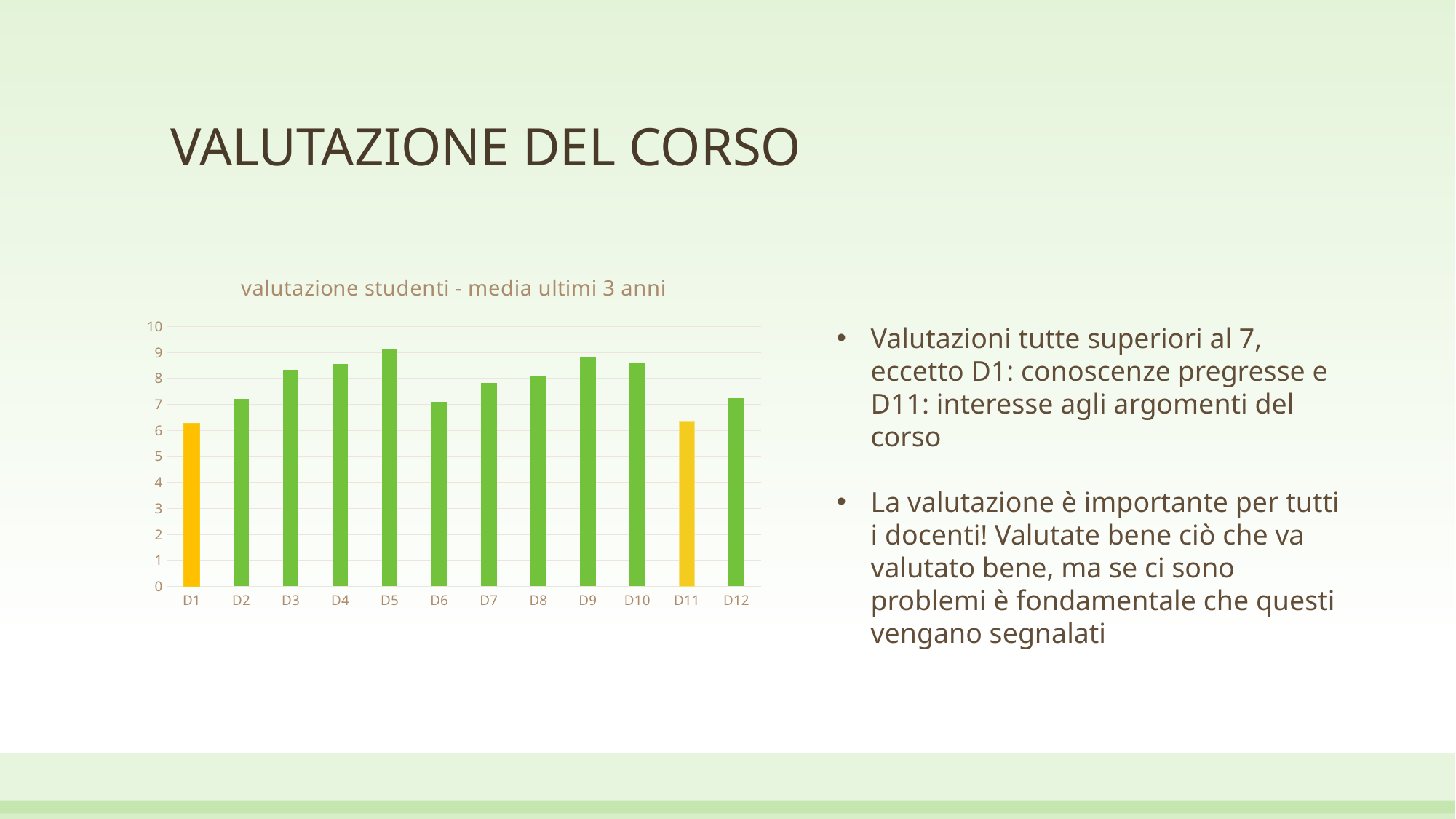
Is the value for D1 greater or less than 7? less Which has the larger value, D9 or D6? D9 How many categories are shown on the x axis of the chart? 12 Is the value for D5 greater or less than 9? greater Which two bars in the chart are coloured yellow instead of green? D1 and D11 Which category has the highest value in the chart? D5 Is the value for D3 greater or less than 8? greater Which has the larger value, D5 or D2? D5 What kind of chart is shown on the slide? bar chart What is the title of the chart? valutazione studenti - media ultimi 3 anni